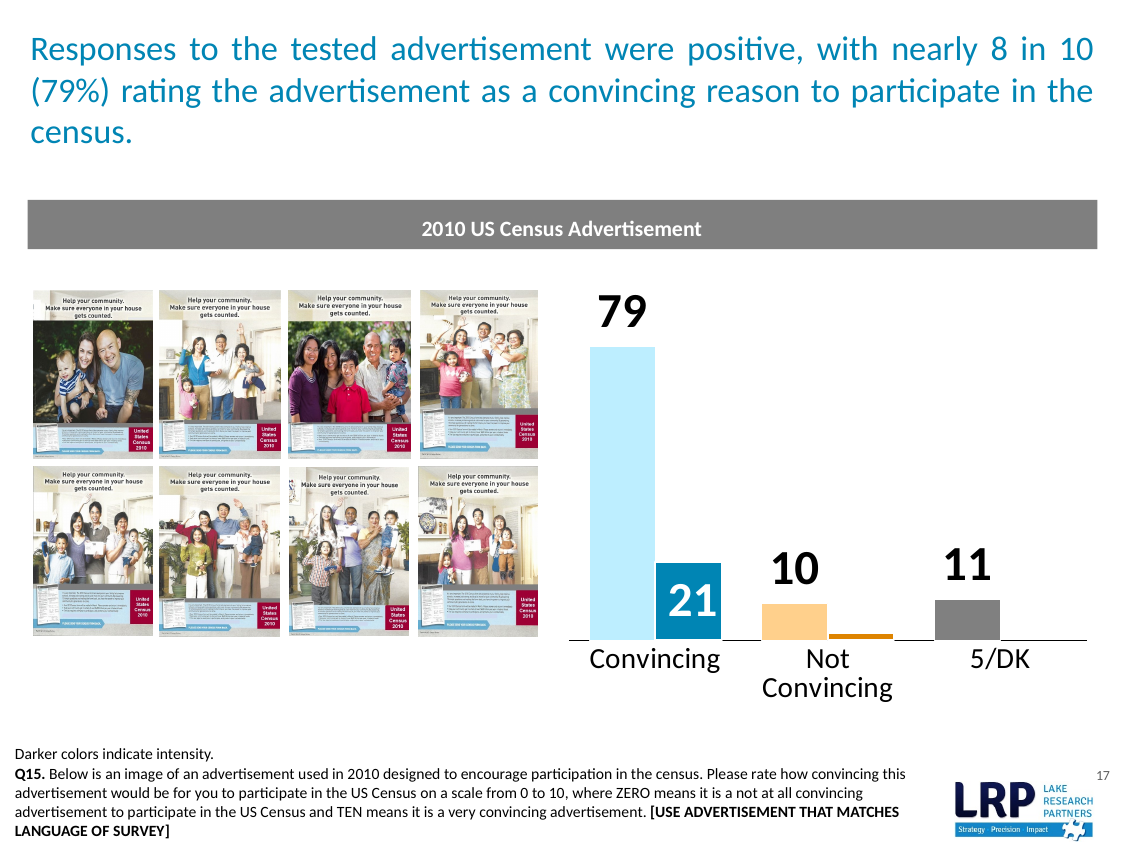
What value is shown for the Not Convincing category? 10 What value is printed on the darker bar within the Convincing category? 21 According to the note on the slide, what do darker colors in the chart indicate? Intensity Which is larger, the value for 5/DK or the value for Not Convincing? 5/DK How many categories are shown on the x axis of the chart? 3 What kind of chart is shown on the slide? Bar chart What value is shown for the 5/DK category? 11 What percentage of respondents rated the advertisement as Convincing? 79 What is the title of the chart? 2010 US Census Advertisement Which category has the highest value? Convincing What is the difference between the Convincing value (79) and the Not Convincing value (10)? 69 Which category has the lowest value? Not Convincing